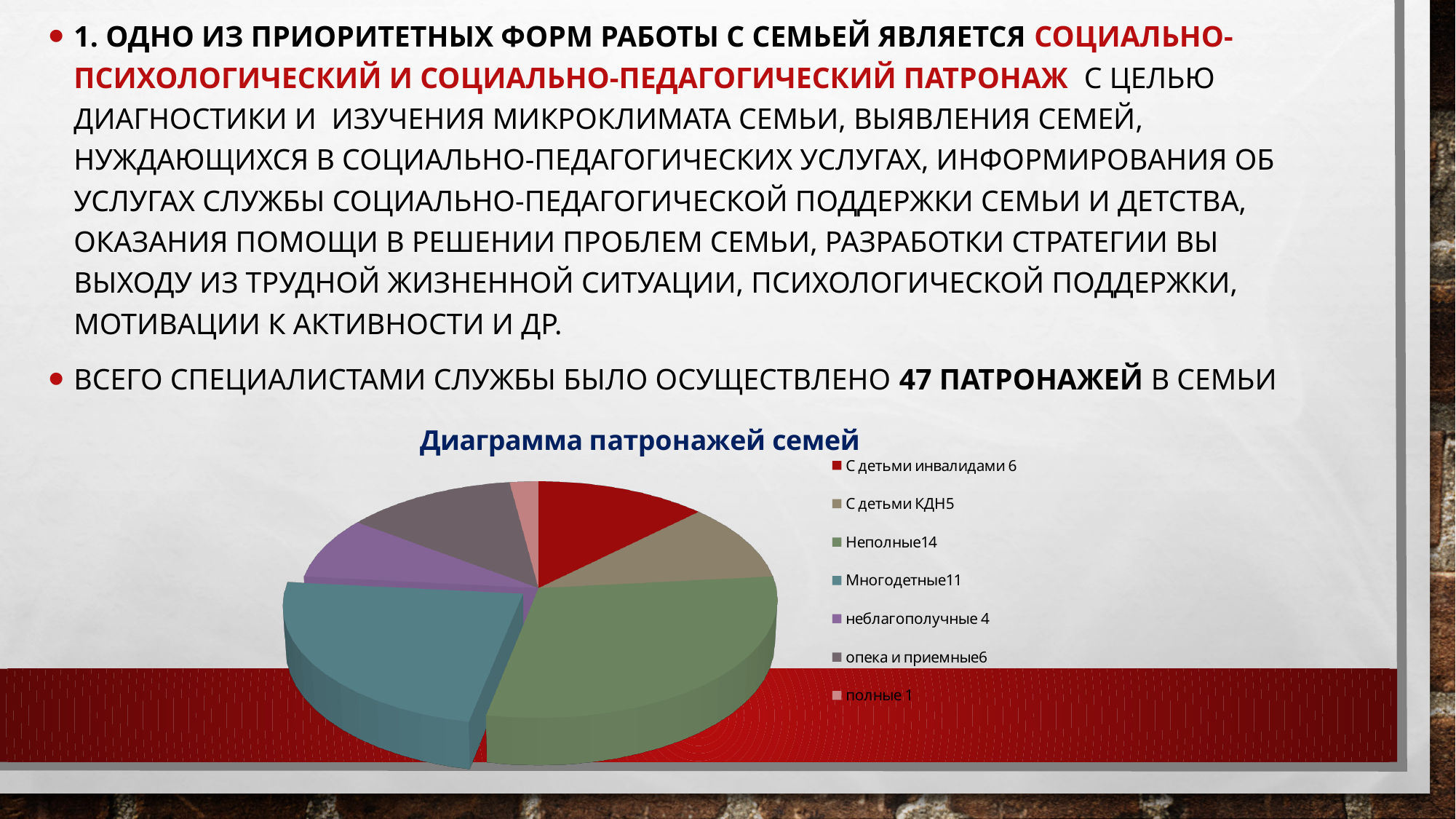
What value is given for the category 'неблагополучные'? 4 How many categories (slices) does the pie chart have? 7 Which is larger: the value for 'С детьми инвалидами' or the value for 'неблагополучные'? С детьми инвалидами What colour is the slice for 'С детьми инвалидами'? red Which category has the largest slice in the pie chart? Неполные What value is given for the category 'Многодетные'? 11 What is the difference between the values for 'Неполные' and 'Многодетные'? 3 What kind of chart is shown on the slide? pie chart What value is given for the category 'С детьми КДН'? 5 What is the total of all the values shown in the pie chart legend? 47 Which category has the smallest slice in the pie chart? полные What is the title of the chart? Диаграмма патронажей семей